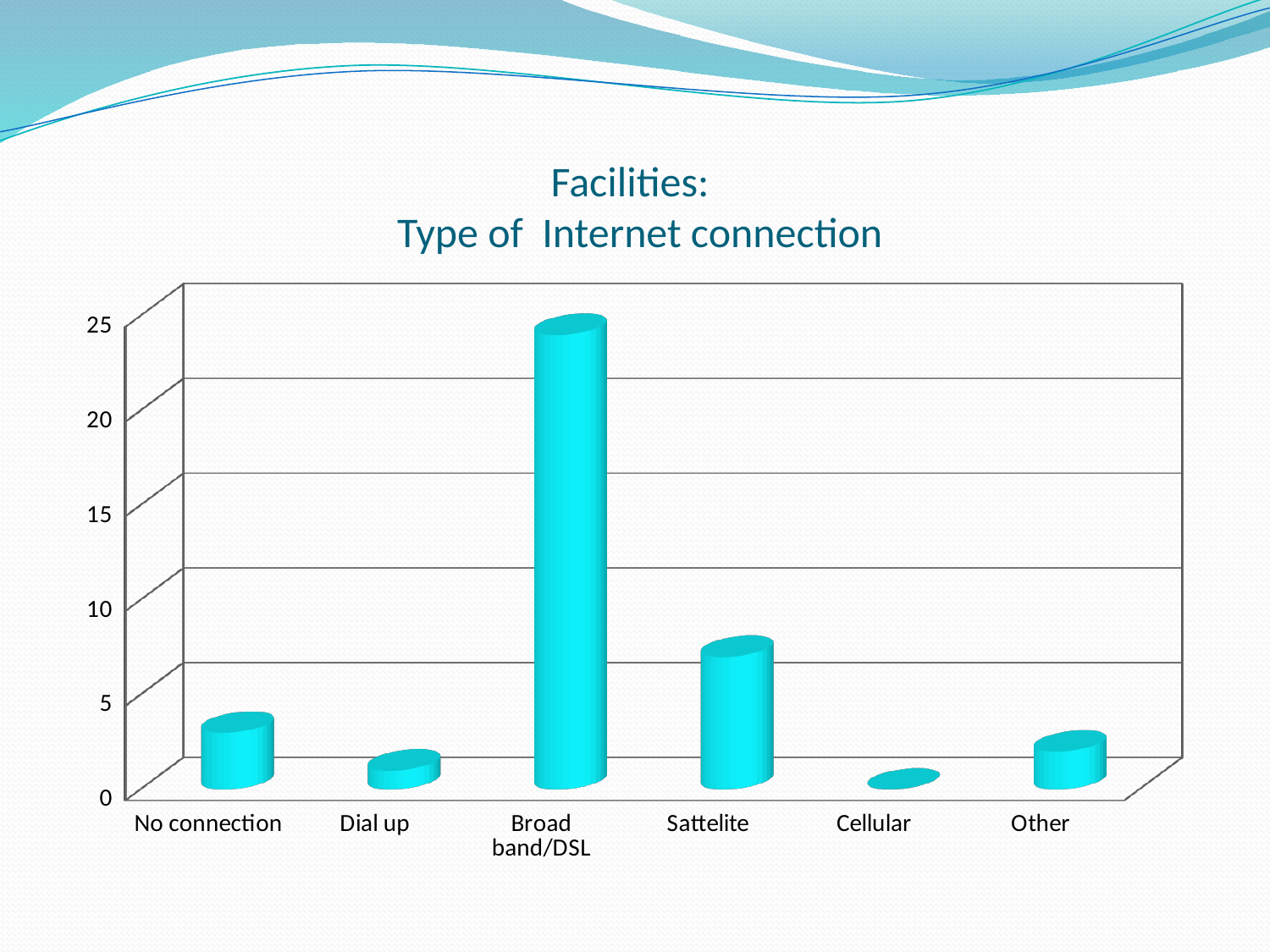
Which is larger, the value for No connection or the value for Dial up? No connection How many types of Internet connection are shown on the x axis? 6 What is the title of the chart? Facilities: Type of Internet connection Is the value for Sattelite greater or less than 5? greater Which type of Internet connection has the lowest bar? Cellular Which type of Internet connection has the highest bar? Broad band/DSL Which is larger, the value for Sattelite or the value for No connection? Sattelite What is the highest value shown on the vertical axis? 25 Is the value for No connection greater or less than 5? less Is the value for Broad band/DSL greater or less than 20? greater What type of chart is shown on the slide? Bar chart